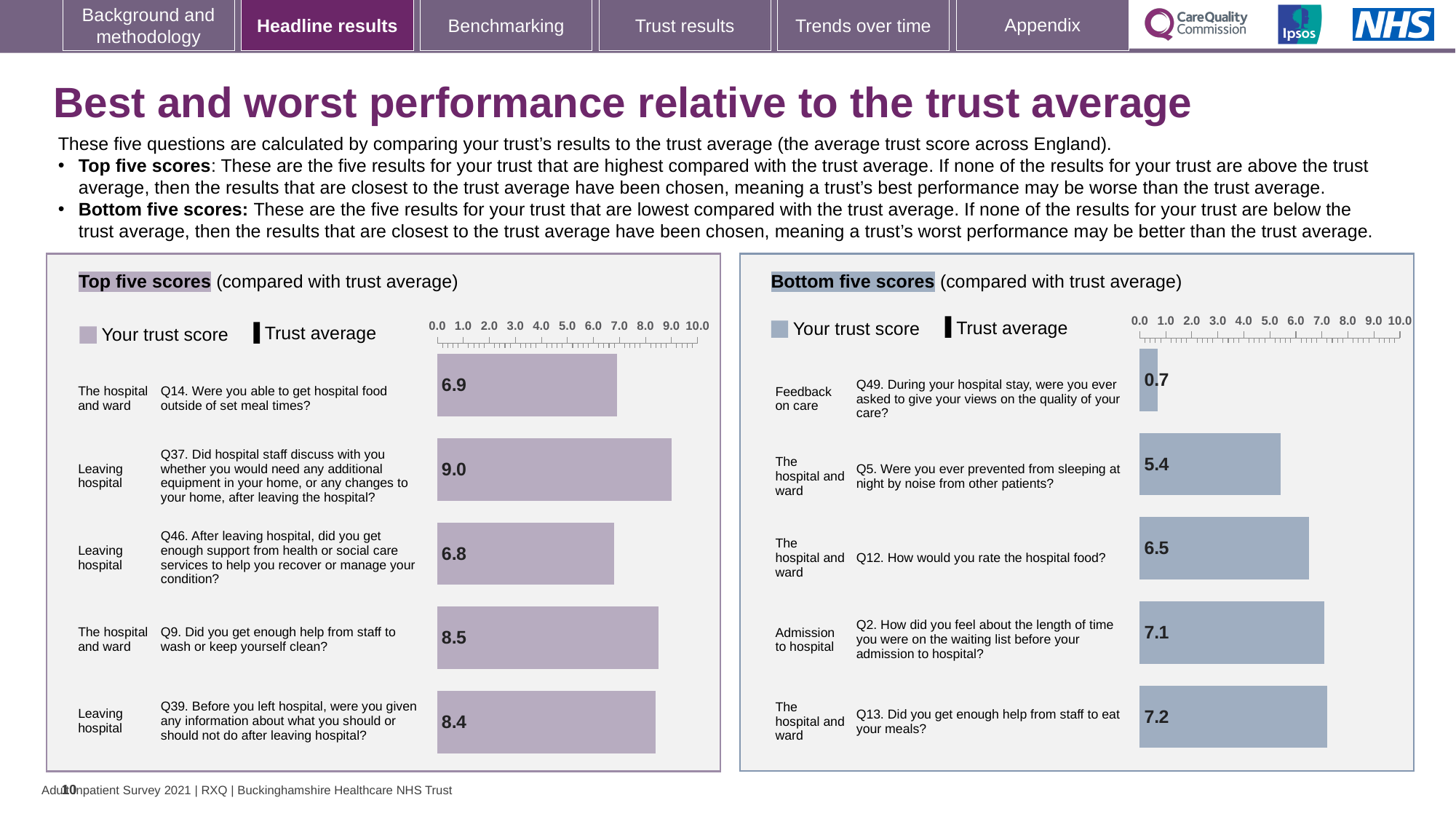
In the Bottom five scores chart, which question has the lowest trust score? Q49 How many questions are shown in the Bottom five scores chart? 5 In the Top five scores chart, what is the trust score for Q37 (staff discussed additional equipment or changes to your home)? 9.0 In the Bottom five scores chart, what is the trust score for Q49 (asked to give your views on the quality of your care)? 0.7 In the Top five scores chart, what is the trust score for Q14 (able to get hospital food outside of set meal times)? 6.9 How many series does the legend of the Top five scores chart list? 2 In the Bottom five scores chart, what is the trust score for Q12 (how would you rate the hospital food)? 6.5 In the Top five scores chart, what is the difference between the trust scores for Q9 and Q39? 0.1 In the Top five scores chart, which question has the highest trust score? Q37 In the Bottom five scores chart, what is the difference between the trust scores for Q13 and Q5? 1.8 In the Bottom five scores chart, which has the larger trust score, Q2 or Q12? Q2 What kind of chart is used in the Top five scores panel? Bar chart